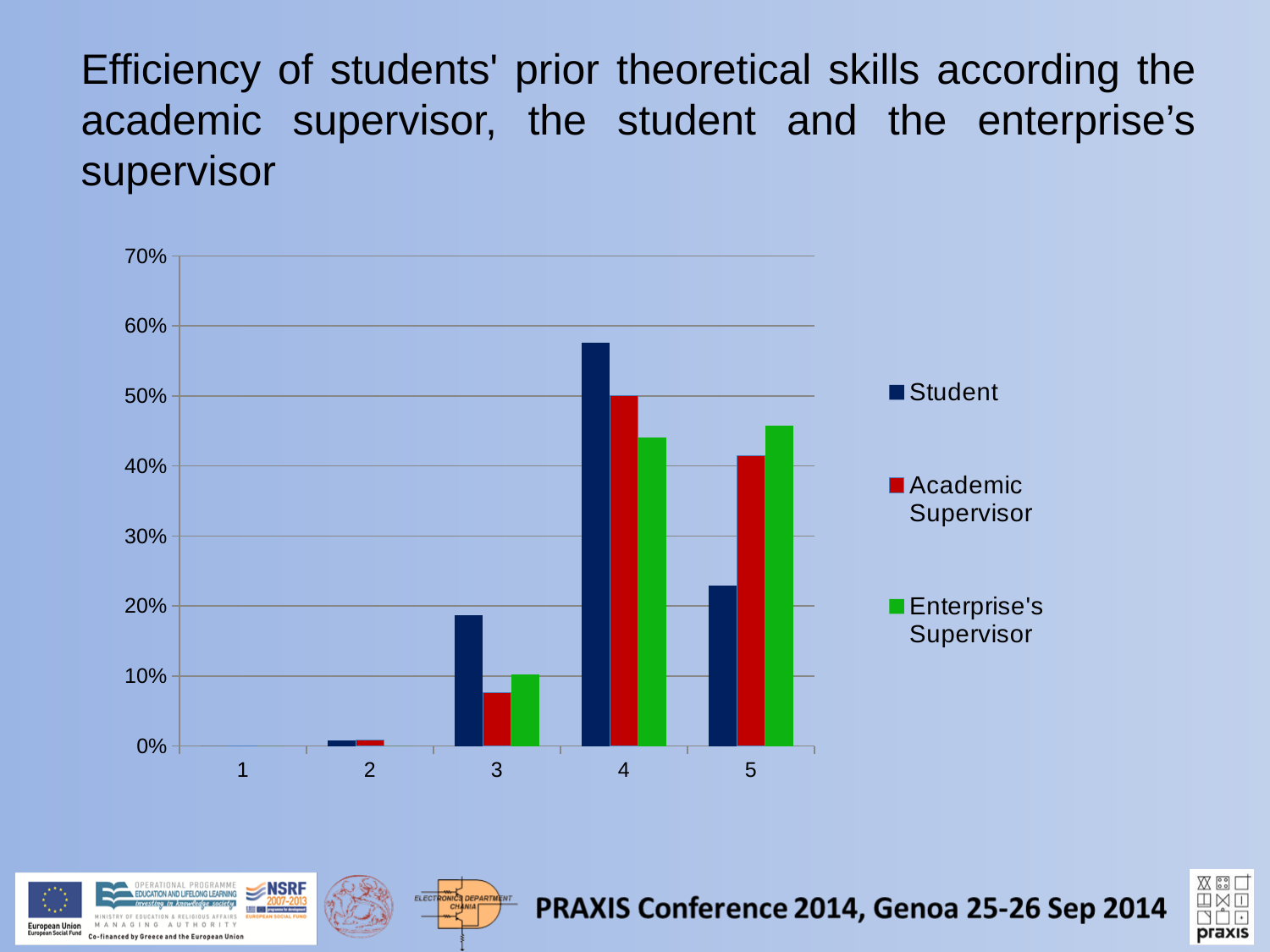
Is the Student value for category 4 greater or less than 50%? greater How many series does the legend list? 3 At category 5, which is larger: the Student value or the Academic Supervisor value? Academic Supervisor What kind of chart is shown on the slide? bar chart Which colour represents the Student series in the legend? dark blue For the Academic Supervisor series, which category has the highest value? 4 At category 3, which is larger: the Student value or the Enterprise's Supervisor value? Student Is the Enterprise's Supervisor value for category 5 greater or less than 40%? greater Is the Student value for category 5 greater or less than 30%? less How many categories are shown on the x axis? 5 For the Student series, which category has the highest value? 4